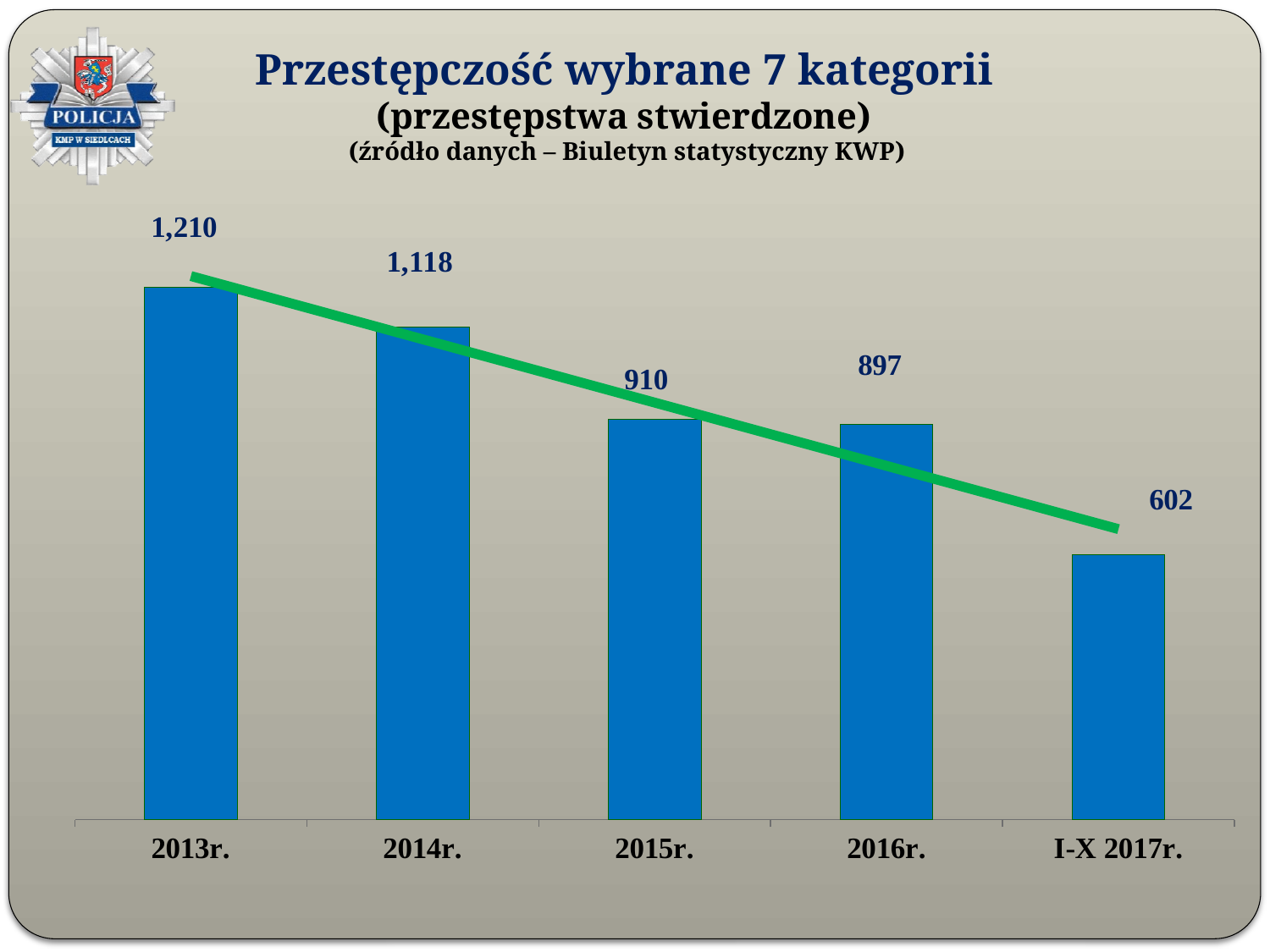
Do the values rise or fall from 2013r. to I-X 2017r.? fall Which is larger, the value for 2014r. or the value for 2016r.? 2014r. What kind of chart is this? bar chart What is the value for 2013r.? 1,210 Which category has the lowest value? I-X 2017r. How many categories are shown on the x axis? 5 What colour is the trend line drawn across the bars? green What is the value for 2015r.? 910 What is the value for I-X 2017r.? 602 What is the difference between the values for 2016r. and I-X 2017r.? 295 What is the difference between the values for 2013r. and 2014r.? 92 Which category has the highest value? 2013r.